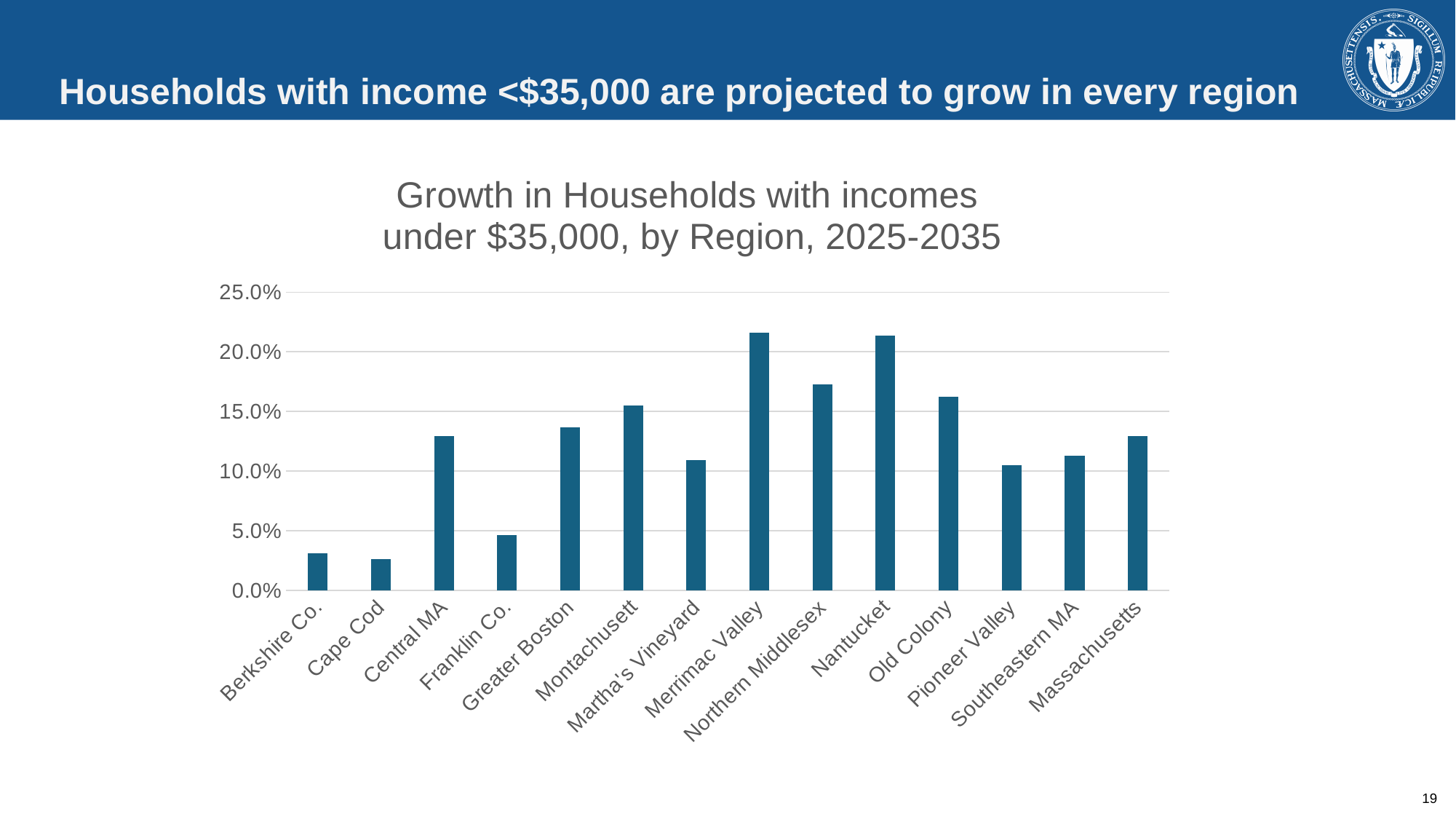
What is the title of the chart? Growth in Households with incomes under $35,000, by Region, 2025-2035 Is the value for Franklin Co. greater or less than 5.0%? less Is the value for Merrimac Valley greater or less than 20.0%? greater Is the value for Northern Middlesex greater or less than 20.0%? less How many regions are shown on the x axis of the chart? 14 What kind of chart is shown on the slide? bar chart Which has a higher value, Montachusett or Greater Boston? Montachusett Which has a higher value, Franklin Co. or Berkshire Co.? Franklin Co. Which has a higher value, Old Colony or Southeastern MA? Old Colony